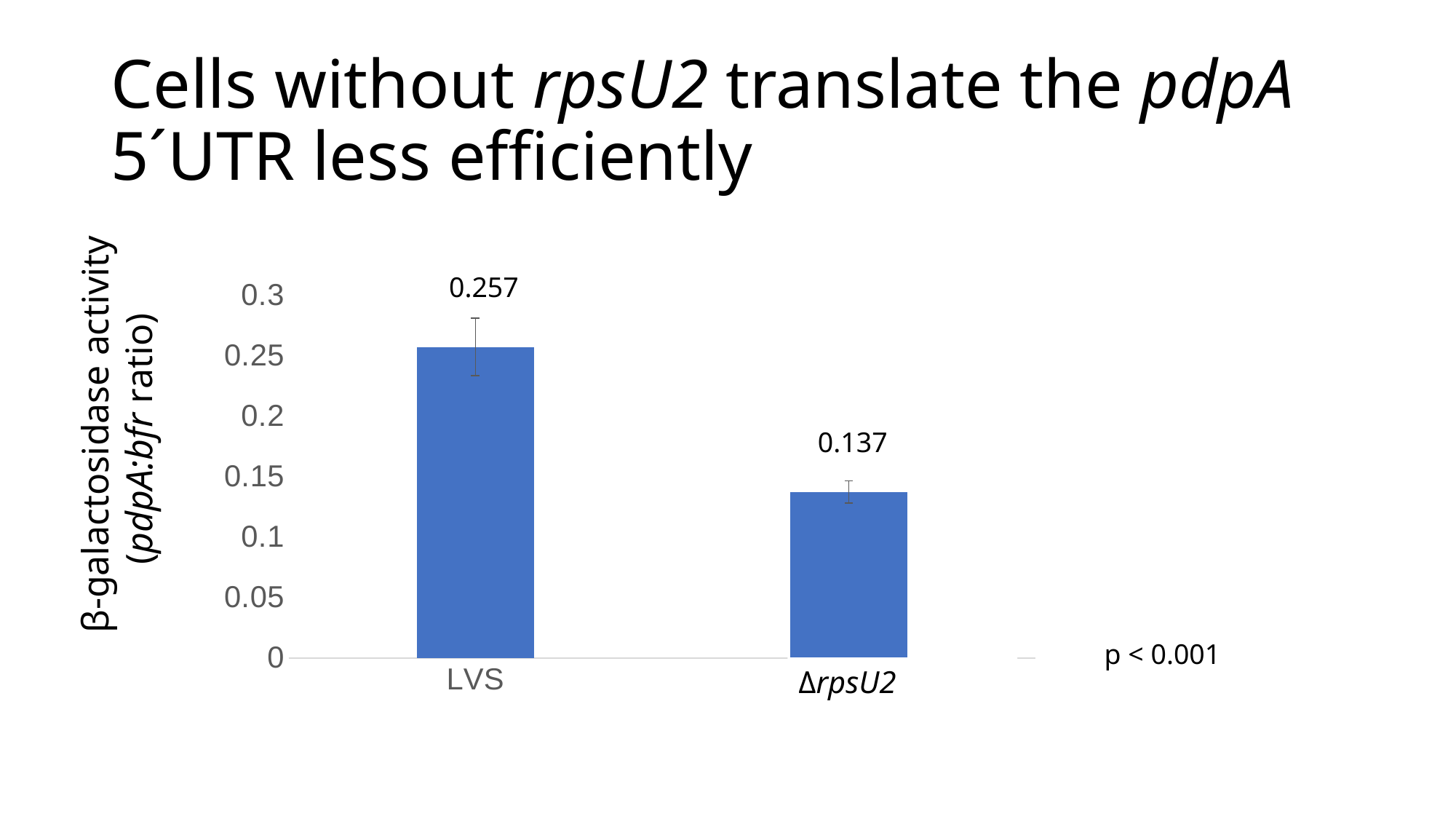
Is the value for ΔrpsU2 greater or less than 0.15? less What p-value is stated next to the chart? p < 0.001 Which category has the highest β-galactosidase activity? LVS Which category has the lowest β-galactosidase activity? ΔrpsU2 Is the value for LVS greater or less than 0.2? greater Which is larger, the value for LVS or the value for ΔrpsU2? LVS How many categories are shown on the x axis? 2 What is the β-galactosidase activity value for LVS? 0.257 What is the difference between the LVS and ΔrpsU2 values? 0.120 What is the β-galactosidase activity value for ΔrpsU2? 0.137 What kind of chart is shown on the slide? bar chart What is the y-axis label of the chart? β-galactosidase activity (pdpA:bfr ratio)